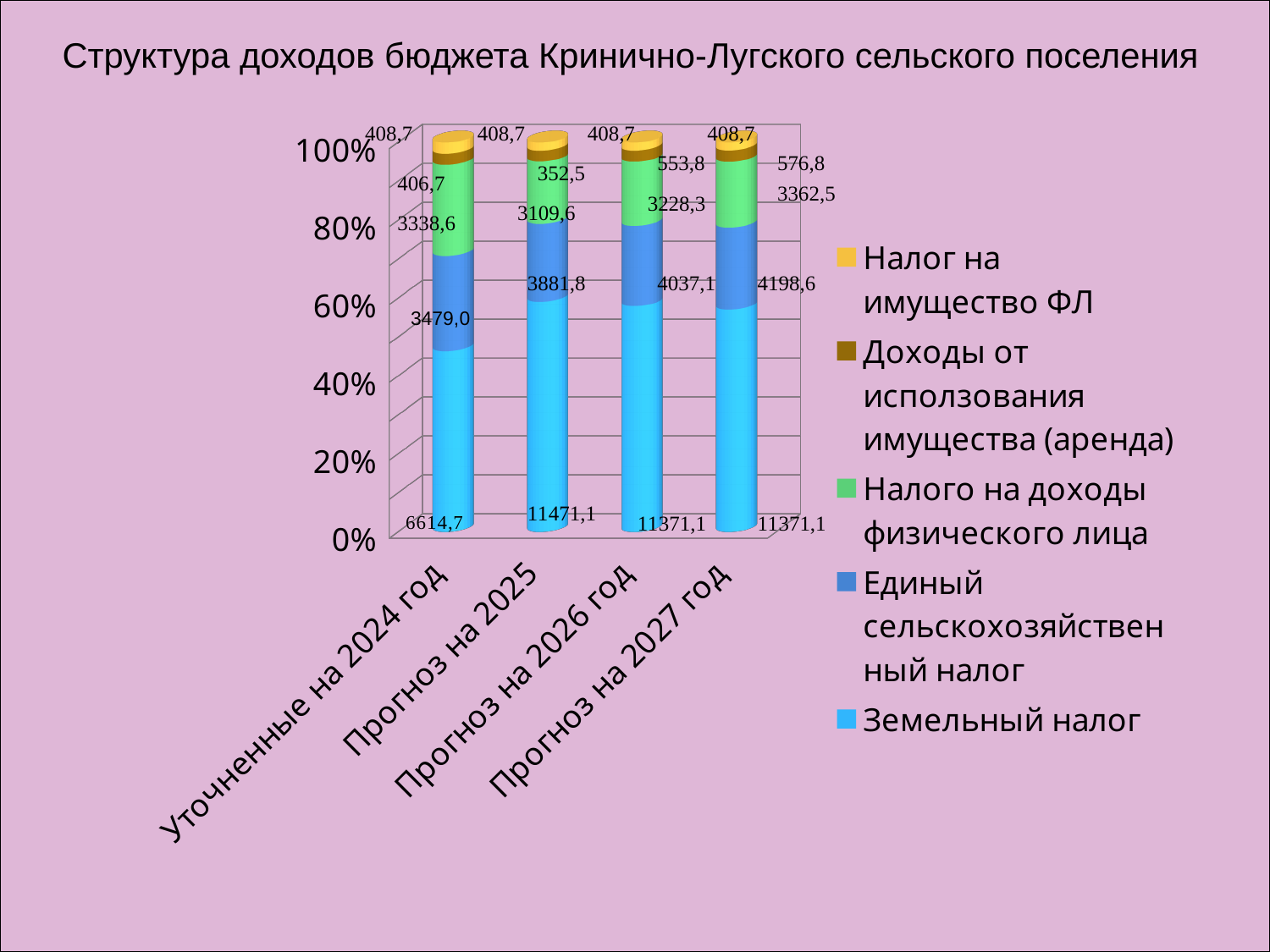
Which is larger: Единый сельскохозяйственный налог for Прогноз на 2026 год or for Прогноз на 2027 год? Прогноз на 2027 год What kind of chart is shown on the slide? Stacked bar chart How many series does the chart legend list? 5 What is the value of Единый сельскохозяйственный налог for Прогноз на 2027 год? 4198,6 Do the values of Единый сельскохозяйственный налог rise or fall from Уточненные на 2024 год to Прогноз на 2027 год? Rise Which category has the highest value for Земельный налог? Прогноз на 2025 What is the value of Налого на доходы физического лица for Уточненные на 2024 год? 3338,6 How many categories are shown along the x axis of the chart? 4 What is the difference between the Земельный налог values for Прогноз на 2025 and Уточненные на 2024 год? 4856,4 What is the title of the chart? Структура доходов бюджета Кринично-Лугского сельского поселения What is the value of Земельный налог for Прогноз на 2025? 11471,1 Which category has the lowest value for Доходы от исползования имущества (аренда)? Прогноз на 2025